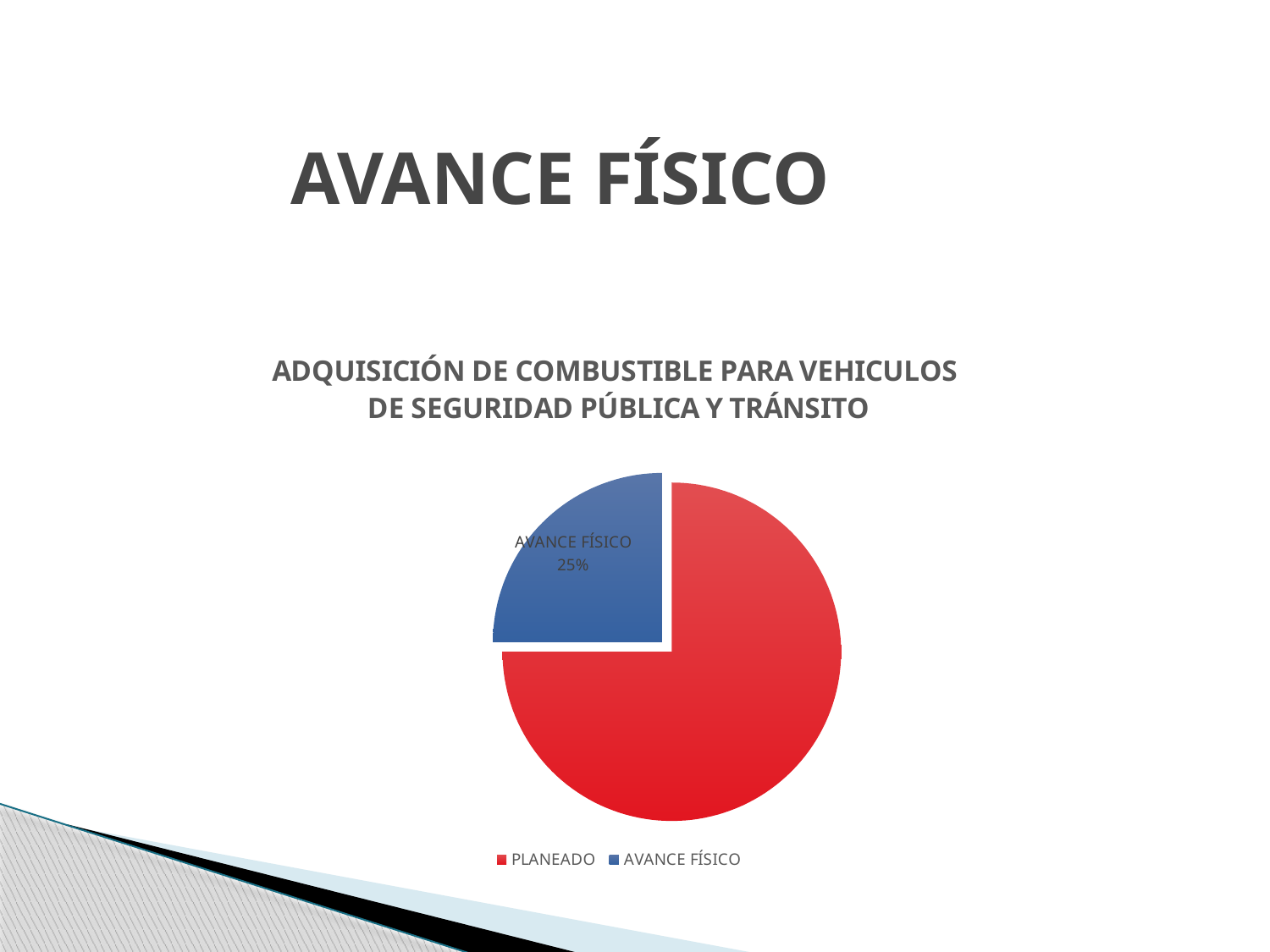
What colour is the PLANEADO slice in the pie chart? red Which is larger, the PLANEADO slice or the AVANCE FÍSICO slice? PLANEADO How many slices does the pie chart have? 2 Which slice of the pie is the smallest? AVANCE FÍSICO How many entries does the legend list? 2 Which slice of the pie is the largest? PLANEADO What is the title of the pie chart? ADQUISICIÓN DE COMBUSTIBLE PARA VEHICULOS DE SEGURIDAD PÚBLICA Y TRÁNSITO What share of the pie does the AVANCE FÍSICO slice represent? 25% What is the value printed on the AVANCE FÍSICO slice? 25% What kind of chart is shown on the slide? pie chart